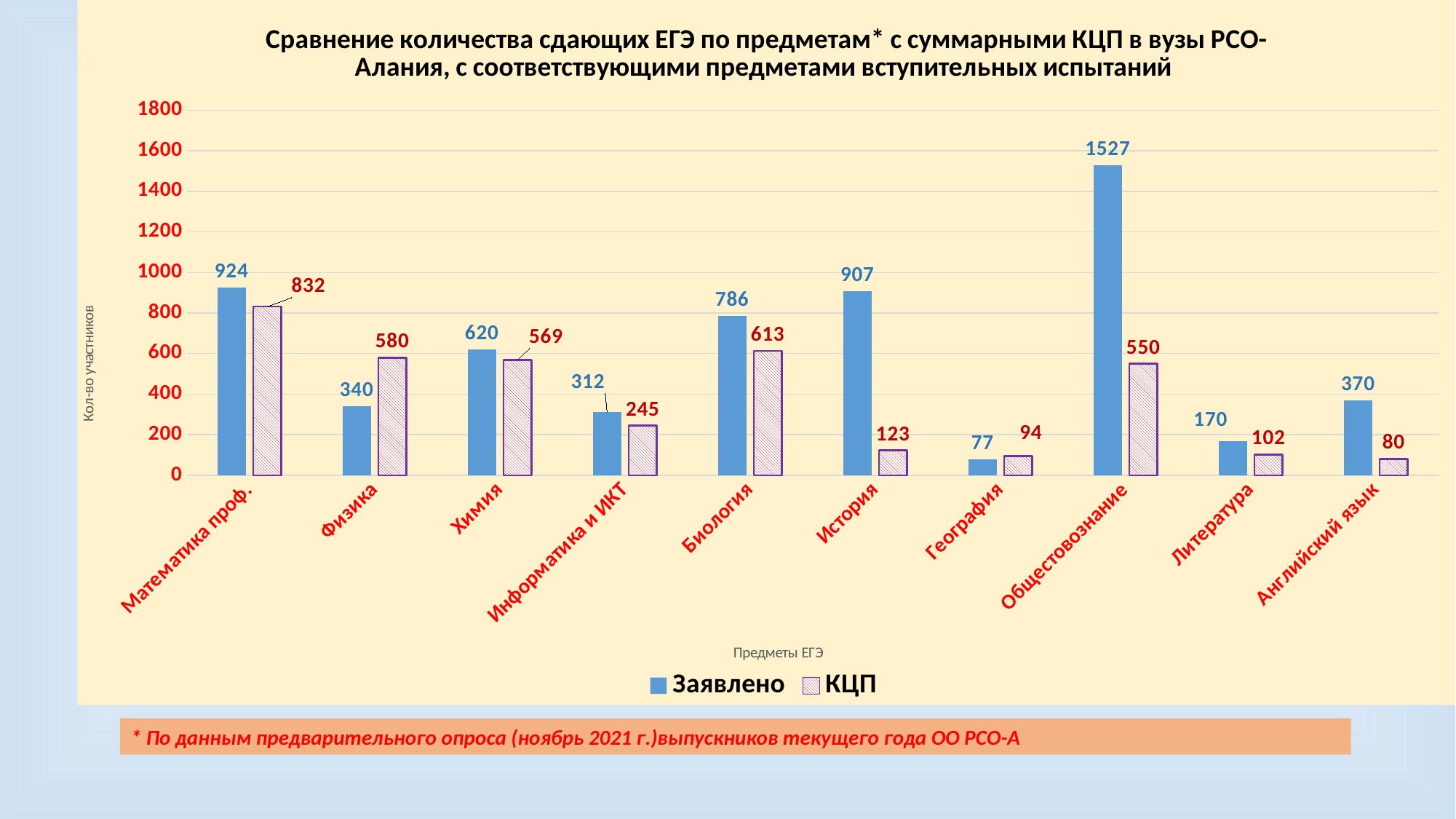
Which category has the lowest value in the КЦП series? Английский язык What is the difference between the Заявлено and КЦП values for История? 784 How many series does the legend list? 2 Is the Заявлено value for Биология greater or less than 800? less Which category has the highest value in the Заявлено series? Обществознание What kind of chart is shown on the slide? bar chart What is the value of the Заявлено series for Обществознание? 1527 What is the value of the Заявлено series for Информатика и ИКТ? 312 How many subject categories are shown on the x axis? 10 What is the label of the y axis? Кол-во участников Which is larger for Физика: the Заявлено value or the КЦП value? КЦП What is the value of the КЦП series for Физика? 580